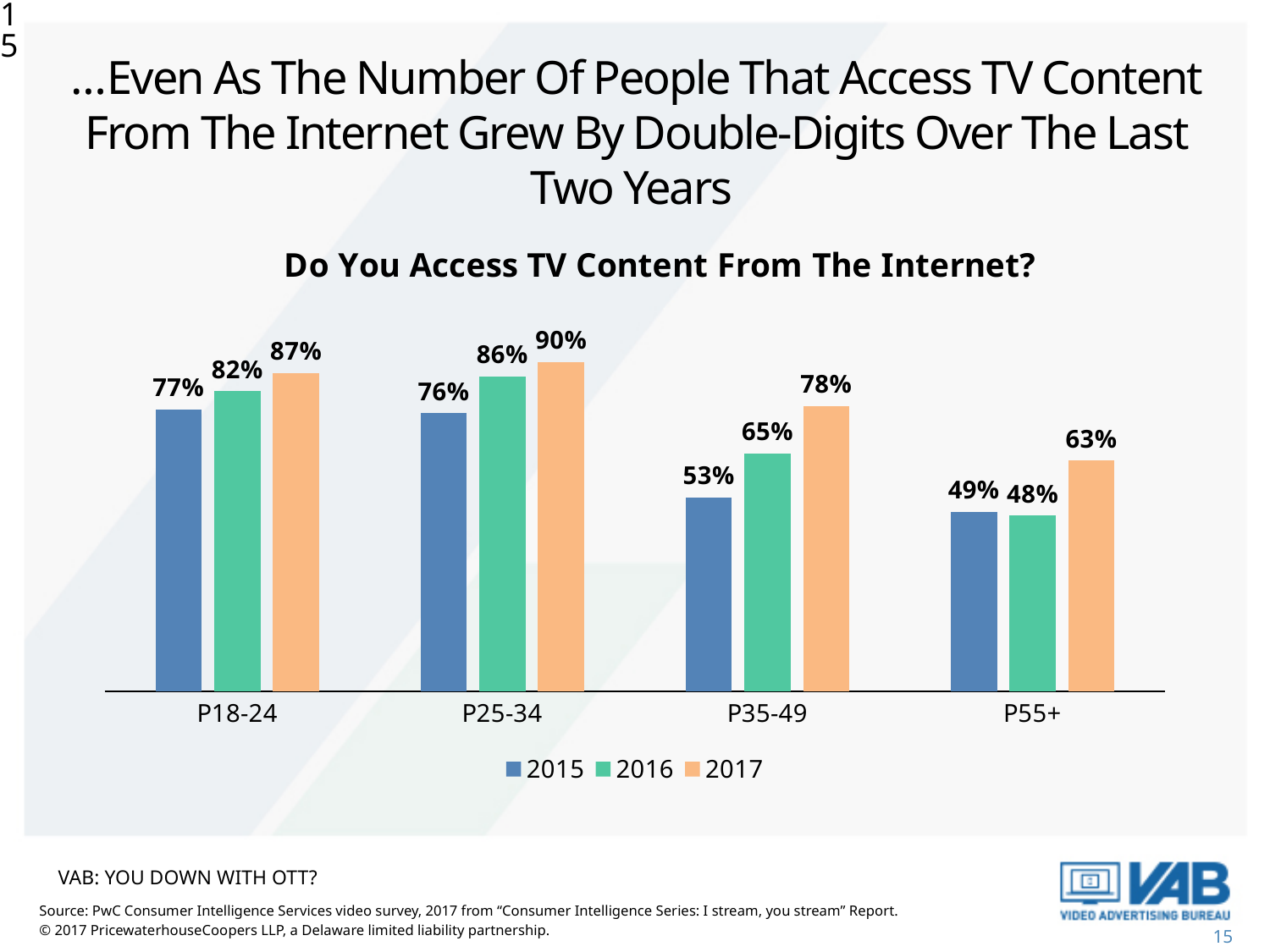
What kind of chart is shown? Bar chart Which age group has the highest value in 2017? P25-34 How many age groups are shown on the x axis? 4 Which age group has the lowest value in 2016? P55+ What is the title of the chart? Do You Access TV Content From The Internet? What is the value for P35-49 in 2016? 65% How many series does the legend list? 3 What is the value for P55+ in 2015? 49% Which is larger for P55+: the 2015 value or the 2016 value? 2015 Do the values for P25-34 rise or fall from 2015 to 2017? Rise What is the value for P18-24 in 2017? 87% What is the difference between the 2017 and 2015 values for P35-49? 25%